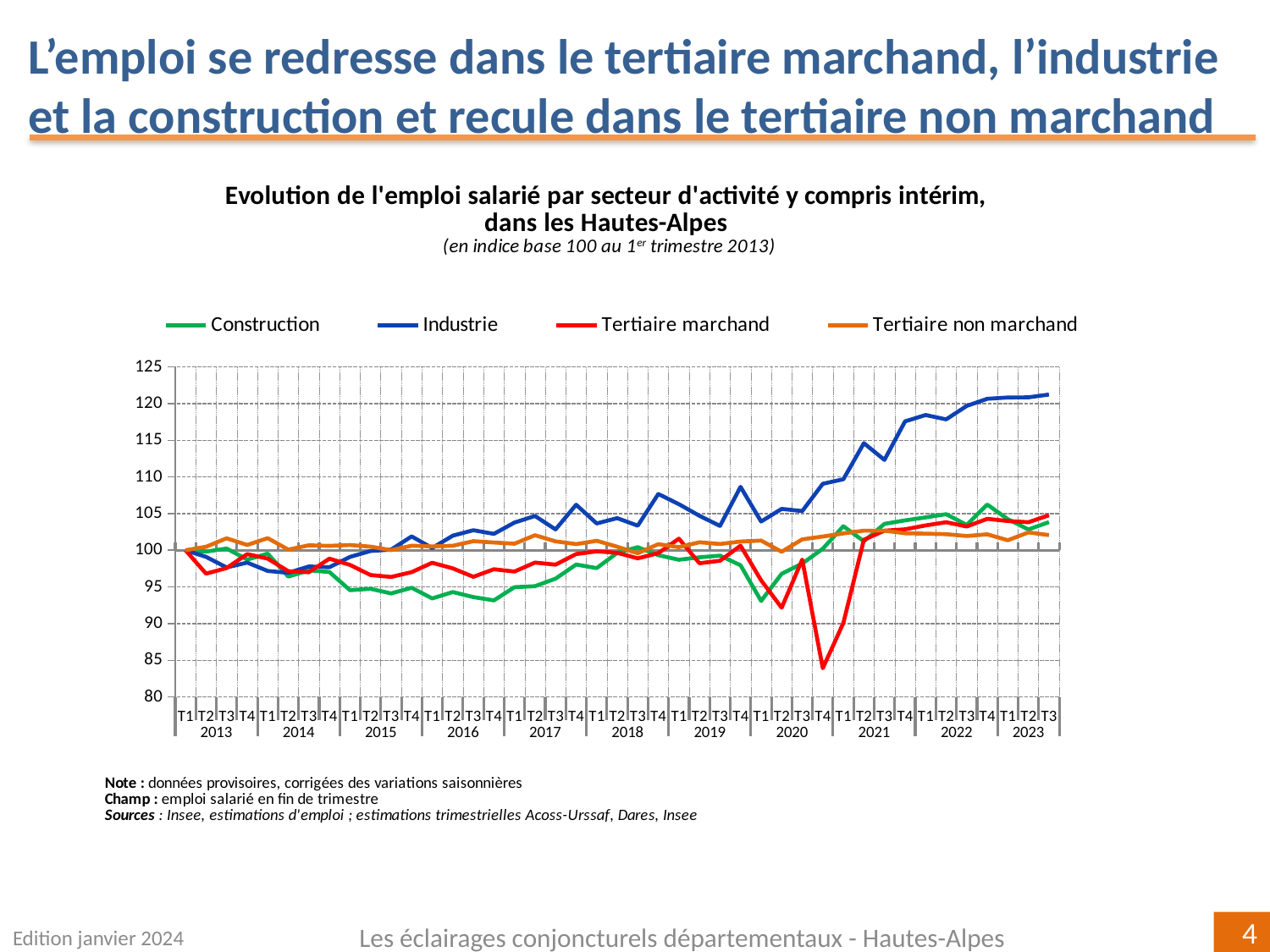
Is the value for Construction at T4 2016 greater or less than 95? less How many series does the legend list? 4 Which series has the highest value at T3 2023? Industrie Does the Industrie series rise or fall between T1 2020 and T3 2023? rise At T3 2023, which is higher: Industrie or Construction? Industrie What base is used for the index in this chart, according to the subtitle? indice base 100 au 1er trimestre 2013 Is the value for Industrie at T3 2023 greater or less than 120? greater Which series has the lowest value at T4 2020? Tertiaire marchand Is the value for Tertiaire marchand at T4 2020 greater or less than 90? less What kind of chart is shown on the slide? line chart